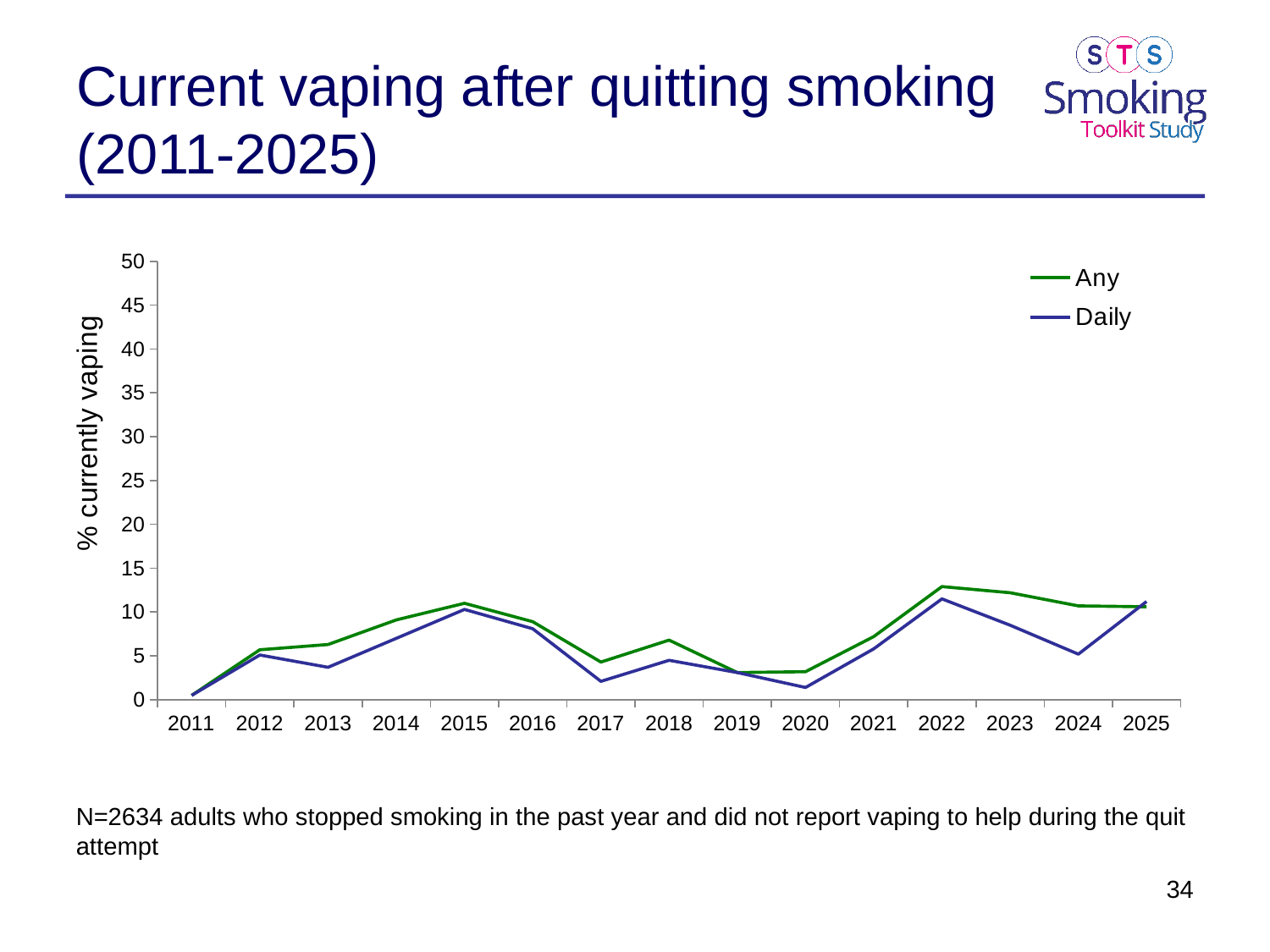
In 2024, which series has the larger value, Any or Daily? Any Which year has the lowest value for the Daily series? 2011 What kind of chart is shown on the slide? line chart Does the Any series rise or fall from 2019 to 2022? rise Is the value for Any in 2022 greater or less than 10? greater Is the value for Daily in 2017 greater or less than 5? less Is the value for Any in 2019 greater or less than 5? less Which year has the lowest value for the Any series? 2011 What is the label on the y axis? % currently vaping How many years are plotted along the x axis? 15 How many series does the legend list? 2